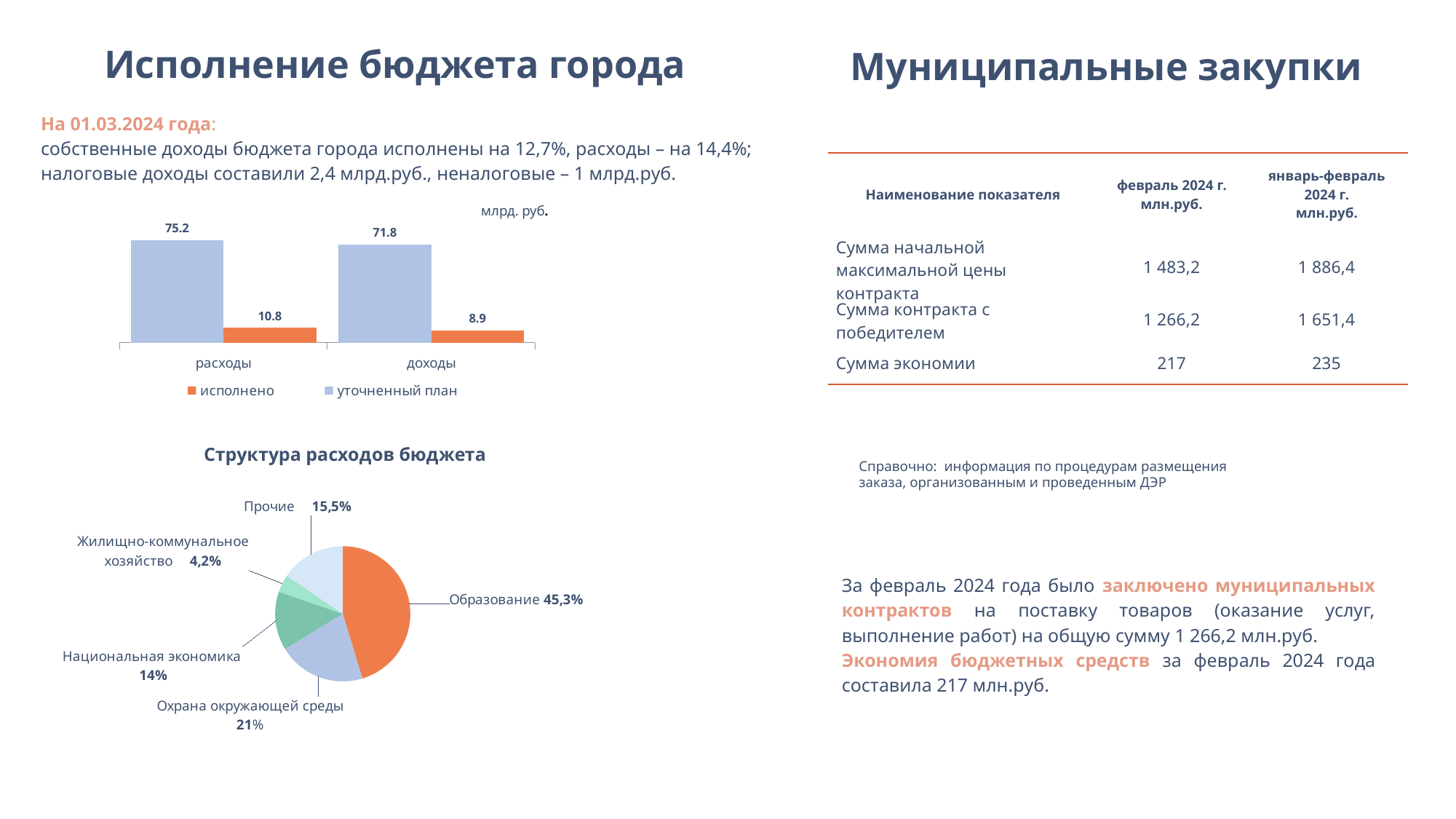
In the chart 'Структура расходов бюджета', which category has the smallest share? Жилищно-коммунальное хозяйство In the chart 'Структура расходов бюджета', what share does 'Образование' have? 45,3% In the bar chart at the top left, what is the value of 'уточненный план' for 'расходы'? 75.2 In the chart 'Структура расходов бюджета', which category has the largest share? Образование What kind of chart is the chart at the top left of the slide? bar chart In the chart 'Структура расходов бюджета', how many slices does the pie have? 5 In the bar chart at the top left, how many categories are shown on the x axis? 2 In the bar chart at the top left, which category has the higher 'уточненный план' value, 'расходы' or 'доходы'? расходы In the bar chart at the top left, what is the difference between 'уточненный план' and 'исполнено' for 'расходы'? 64.4 In the bar chart at the top left, which colour represents the 'исполнено' series? orange In the bar chart at the top left, what is the value of 'исполнено' for 'доходы'? 8.9 In the bar chart at the top left, how many series does the legend list? 2